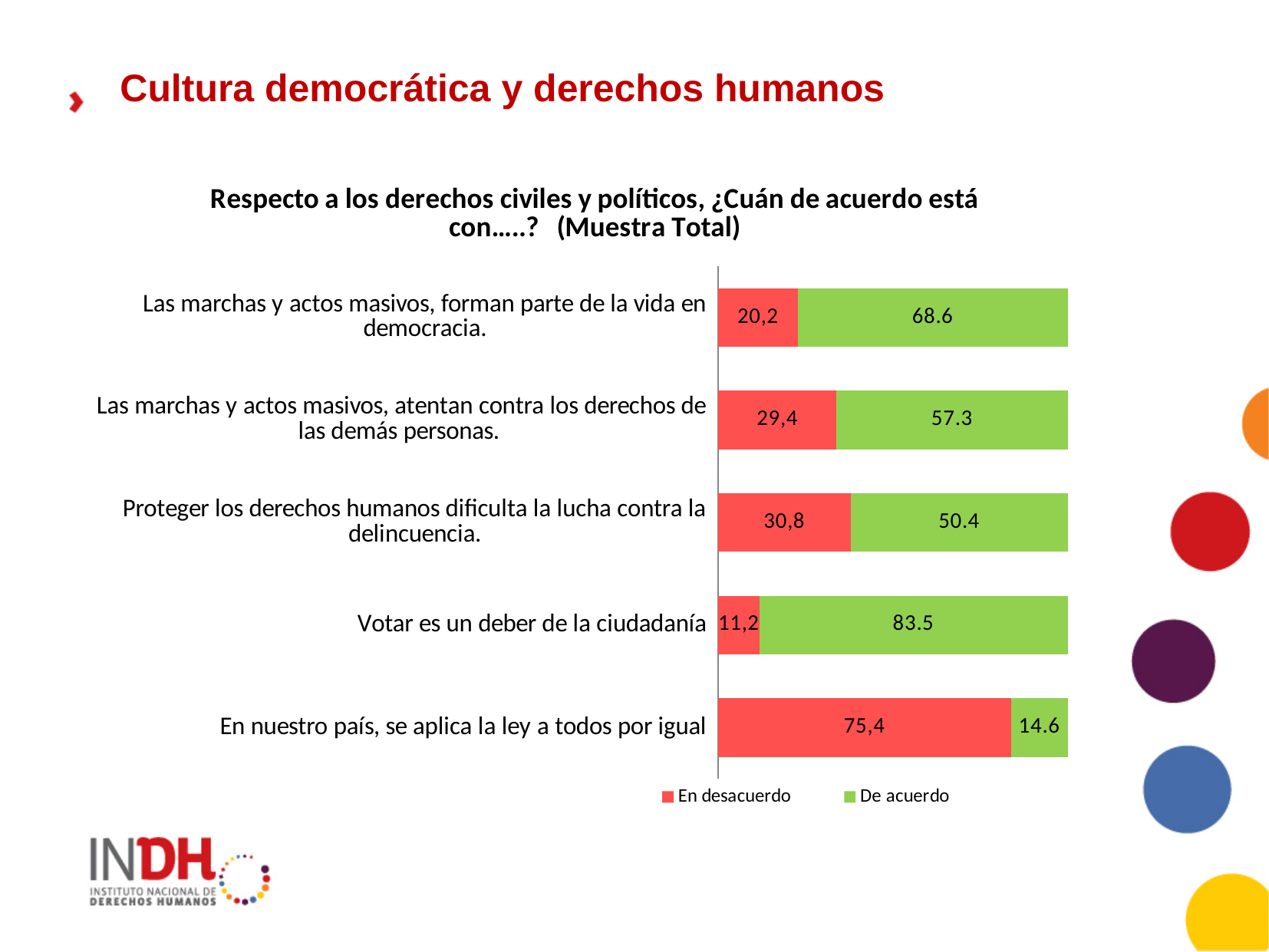
What is the 'De acuerdo' value for 'Votar es un deber de la ciudadanía'? 83.5 Which statement has the highest 'De acuerdo' value? Votar es un deber de la ciudadanía Which statement has the lowest 'En desacuerdo' value? Votar es un deber de la ciudadanía What kind of chart is shown on the slide? Stacked horizontal bar chart How many statements (categories) are shown in the chart? 5 What is the 'En desacuerdo' value for 'En nuestro país, se aplica la ley a todos por igual'? 75,4 What is the 'De acuerdo' value for 'Proteger los derechos humanos dificulta la lucha contra la delincuencia.'? 50.4 What is the difference between the 'De acuerdo' values for 'Votar es un deber de la ciudadanía' and 'Las marchas y actos masivos, forman parte de la vida en democracia.'? 14.9 What is the 'En desacuerdo' value for 'Las marchas y actos masivos, atentan contra los derechos de las demás personas.'? 29,4 How many series does the legend list? 2 Which statement has the lowest 'De acuerdo' value? En nuestro país, se aplica la ley a todos por igual Which is larger: the 'De acuerdo' value for 'Las marchas y actos masivos, forman parte de la vida en democracia.' or for 'Las marchas y actos masivos, atentan contra los derechos de las demás personas.'? Las marchas y actos masivos, forman parte de la vida en democracia.